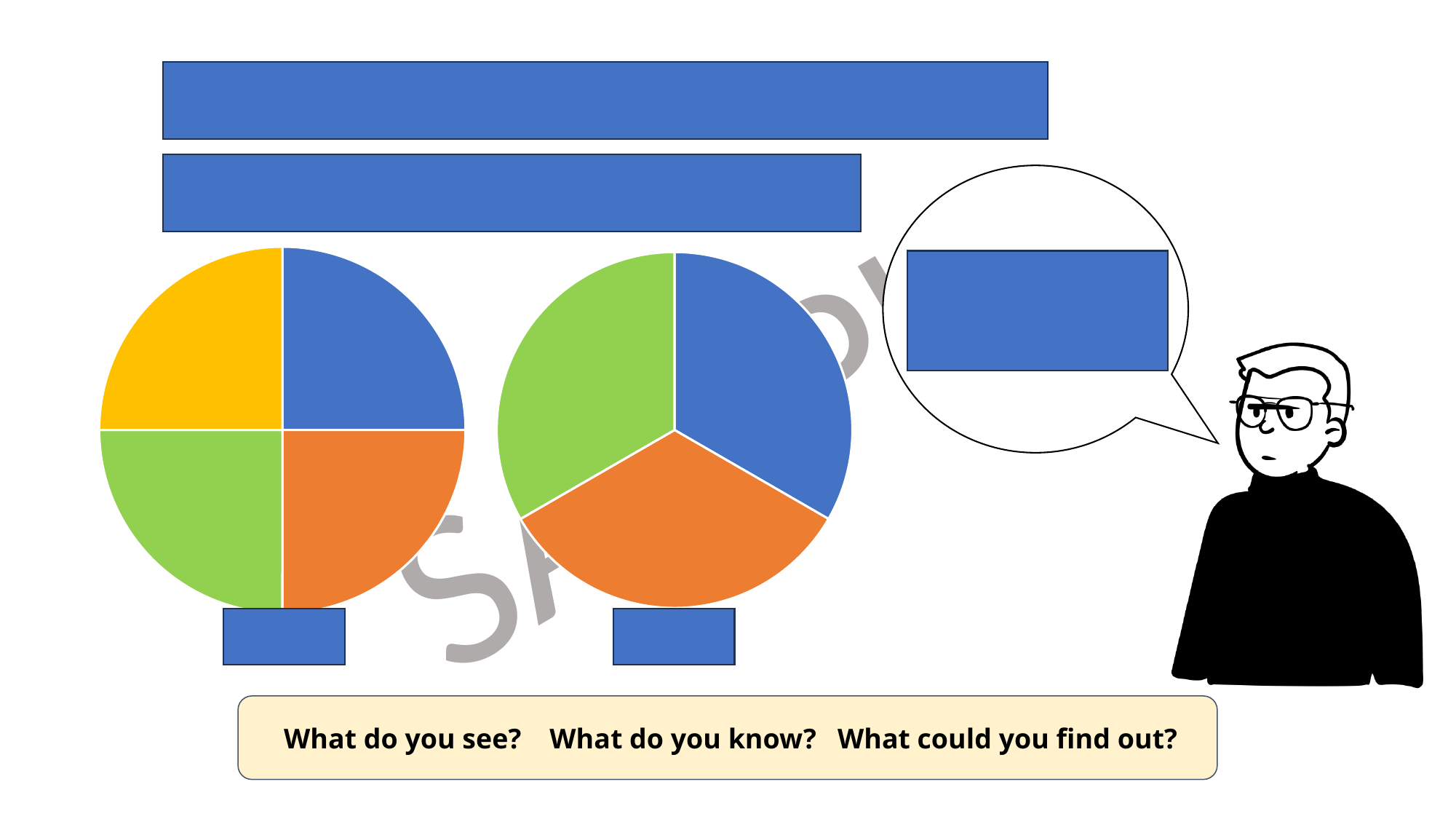
Which chart has more slices, the left pie chart or the right pie chart? the left pie chart What kind of chart is the chart on the right of the slide? pie chart How many pie charts are shown on the slide? 2 How many slices does the right pie chart have? 3 Which colour appears in the left pie chart but not in the right pie chart? yellow What kind of chart is the chart on the left of the slide? pie chart How many slices does the left pie chart have? 4